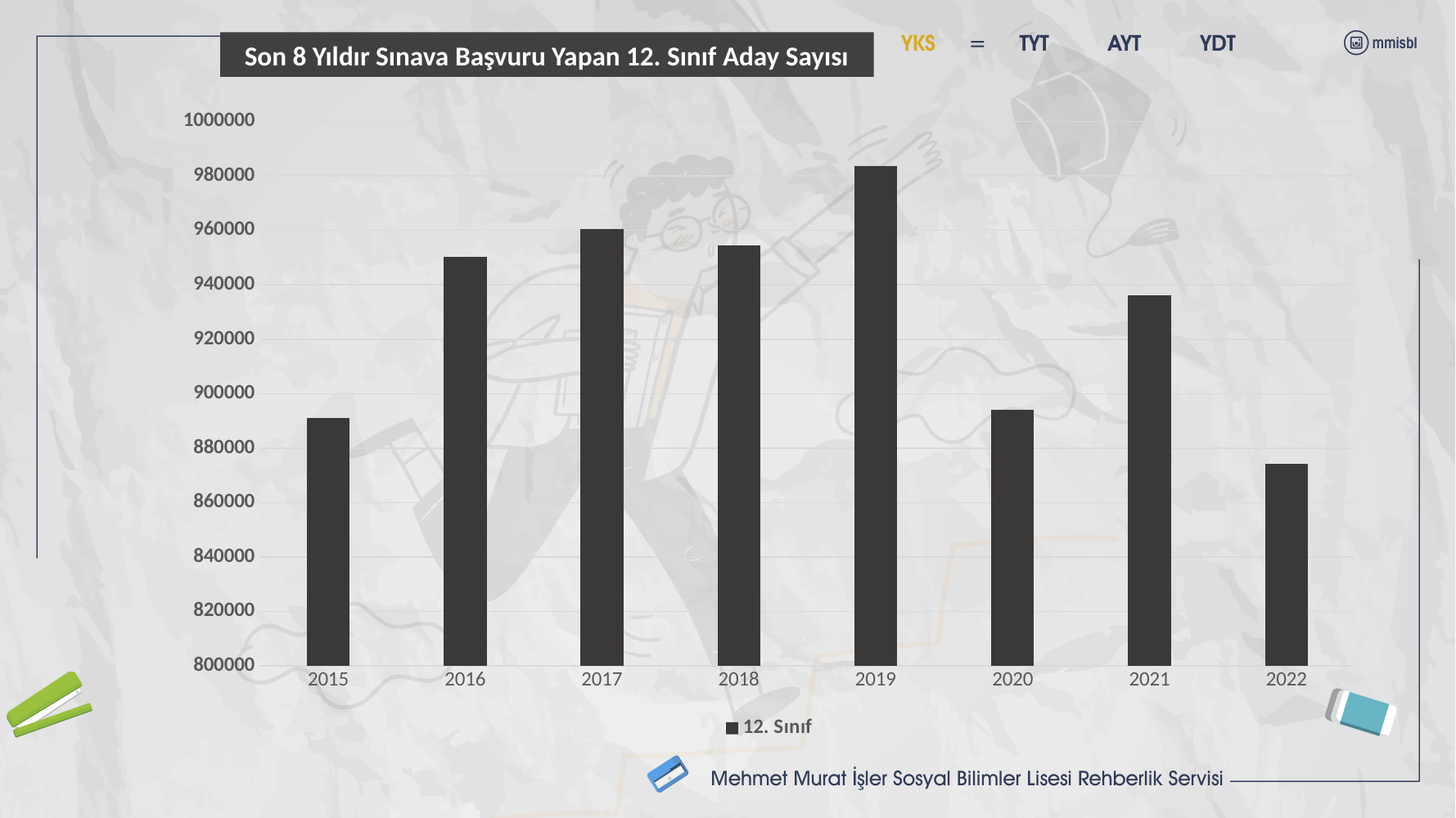
Which year has the lowest number of 12. Sınıf applicants? 2022 Which year has the larger value, 2019 or 2020? 2019 What kind of chart is shown on the slide? bar chart How many years are shown on the x axis of the chart? 8 How many series does the legend list? 1 Which year has the highest number of 12. Sınıf applicants? 2019 Is the value for 2020 greater or less than 900000? less Is the value for 2016 greater or less than 940000? greater Is the value for 2022 greater or less than 880000? less What is the title of the chart? Son 8 Yıldır Sınava Başvuru Yapan 12. Sınıf Aday Sayısı